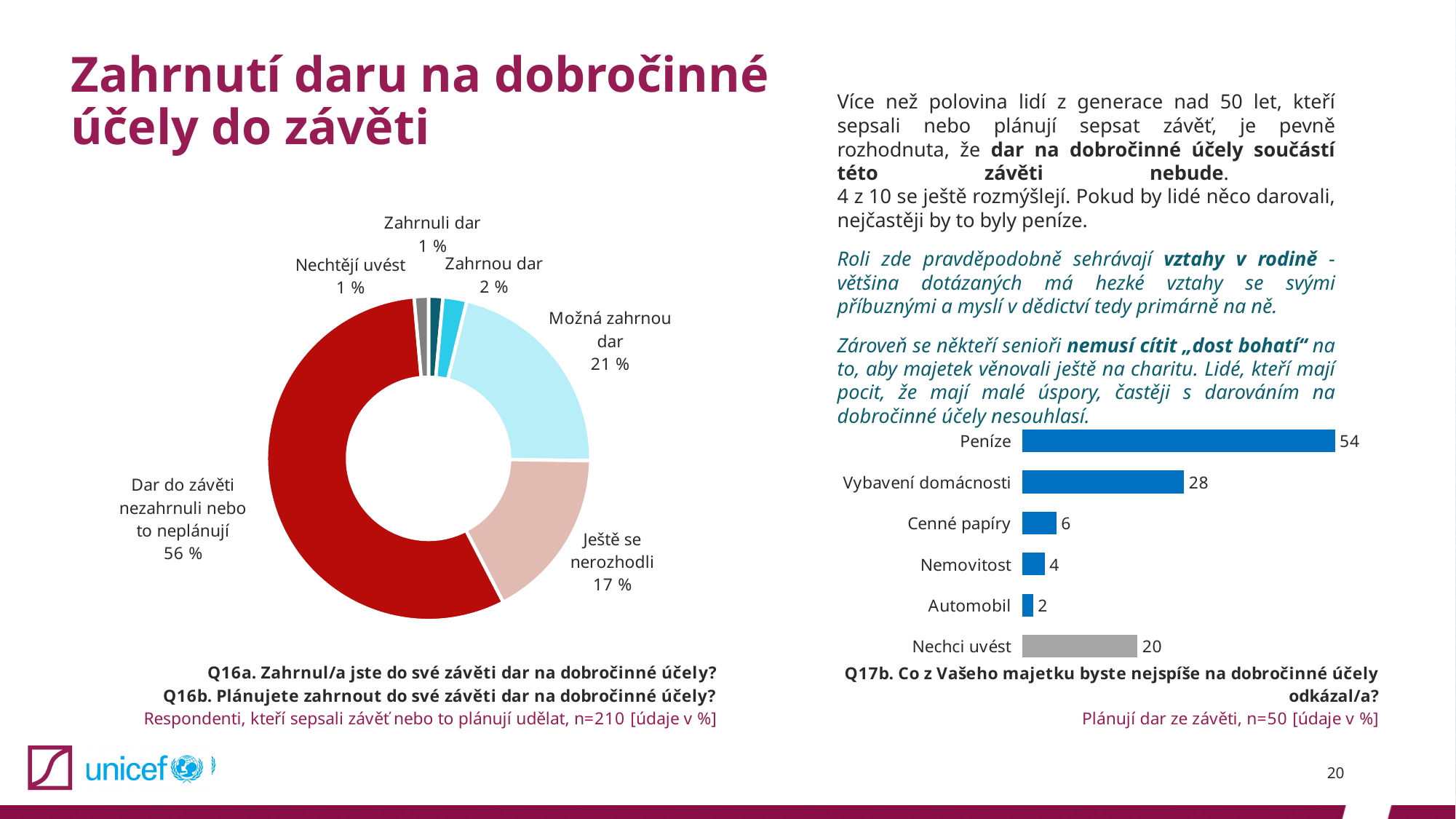
In the bar chart on the right (Q17b), which is larger: "Cenné papíry" or "Nemovitost"? Cenné papíry In the donut chart on the left, how many categories are shown? 6 In the bar chart on the right (Q17b), which category has the lowest value? Automobil What kind of chart is shown on the left side of the slide? Donut (pie) chart In the bar chart on the right (Q17b), what is the difference between "Peníze" and "Vybavení domácnosti"? 26 In the bar chart on the right (Q17b), what is the value for "Vybavení domácnosti"? 28 What kind of chart is shown on the right side of the slide (Q17b)? Bar chart In the donut chart on the left, what is the value for "Možná zahrnou dar"? 21 % In the donut chart on the left, which category has the largest share? Dar do závěti nezahrnuli nebo to neplánují In the donut chart on the left, what share is labelled "Dar do závěti nezahrnuli nebo to neplánují"? 56 % In the bar chart on the right (Q17b), what is the value for "Peníze"? 54 In the donut chart on the left, what is the difference between "Možná zahrnou dar" and "Ještě se nerozhodli"? 4 %